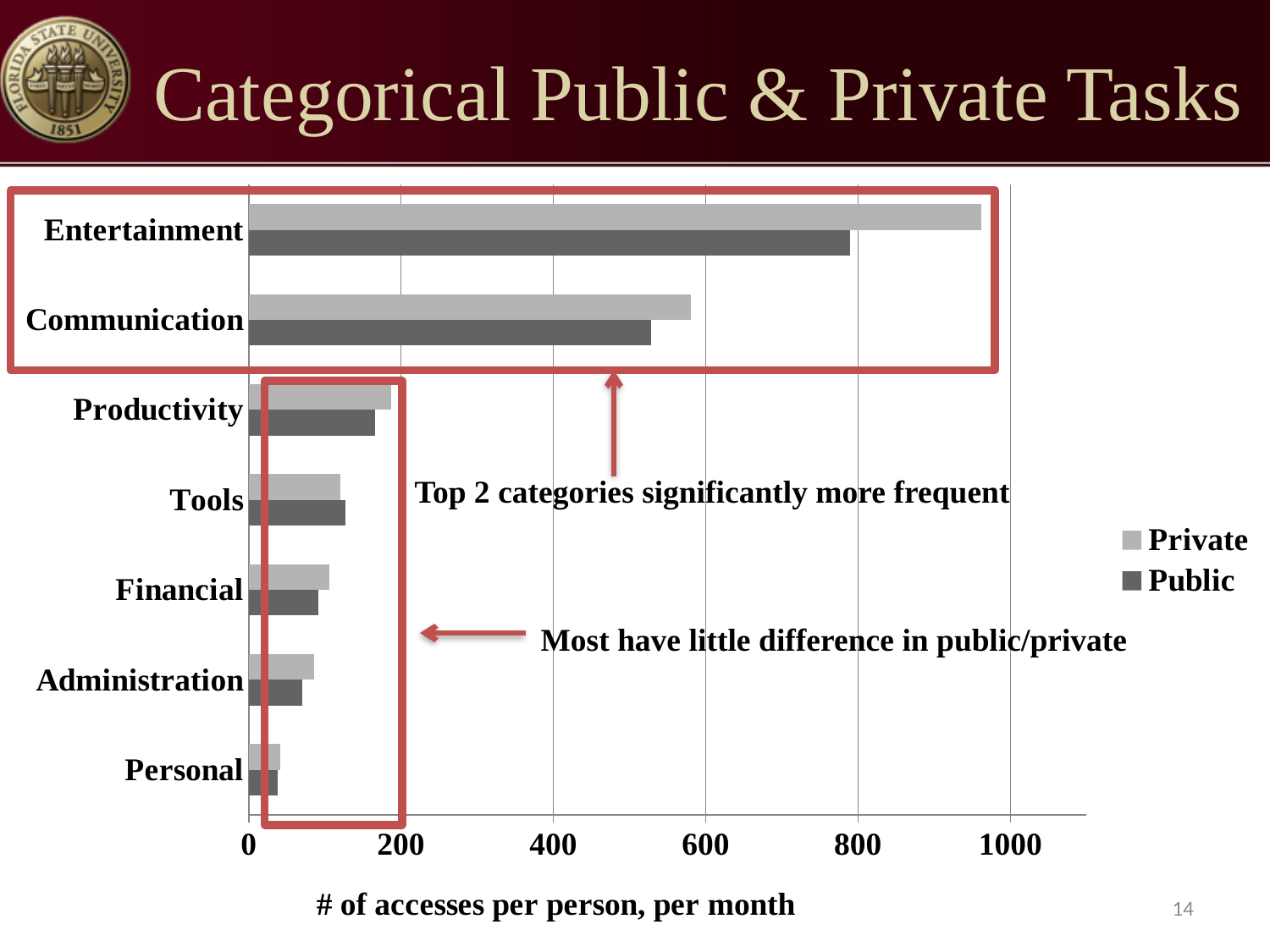
Is the Private value for Entertainment greater or less than 800? greater How many series does the legend list? 2 Is the Public value for Entertainment greater or less than 600? greater What is the label of the horizontal axis? # of accesses per person, per month Which category has the lowest Public value? Personal Which category has the highest Private value? Entertainment Is the Private value for Productivity greater or less than 200? less What kind of chart is shown on the slide? bar chart Which is larger: the Private value for Communication or the Private value for Productivity? Communication For Entertainment, which is larger: the Private value or the Public value? Private How many categories are shown on the chart? 7